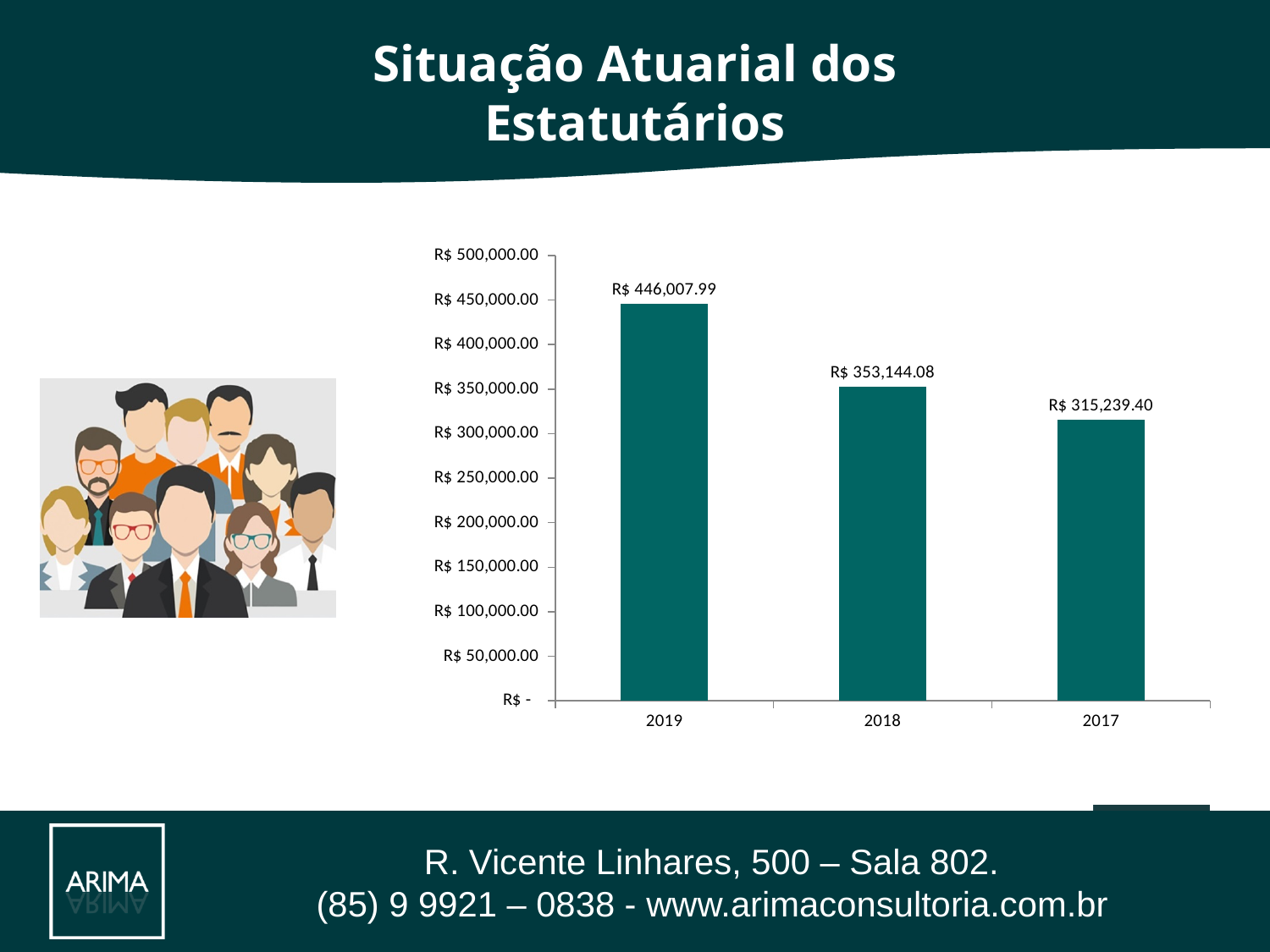
How many years are shown on the x axis? 3 Is the value for 2019 greater or less than R$ 400,000.00? greater What is the difference between the values for 2018 and 2017? R$ 37,904.68 Which year has the highest value? 2019 What kind of chart is shown on the slide? bar chart Which is larger, the value for 2018 or the value for 2017? 2018 Which year has the lowest value? 2017 What is the value shown for 2018? R$ 353,144.08 What is the value shown for 2017? R$ 315,239.40 What is the difference between the values for 2019 and 2018? R$ 92,863.91 Do the bar values rise or fall moving from left to right along the x axis? fall What is the value shown for 2019? R$ 446,007.99